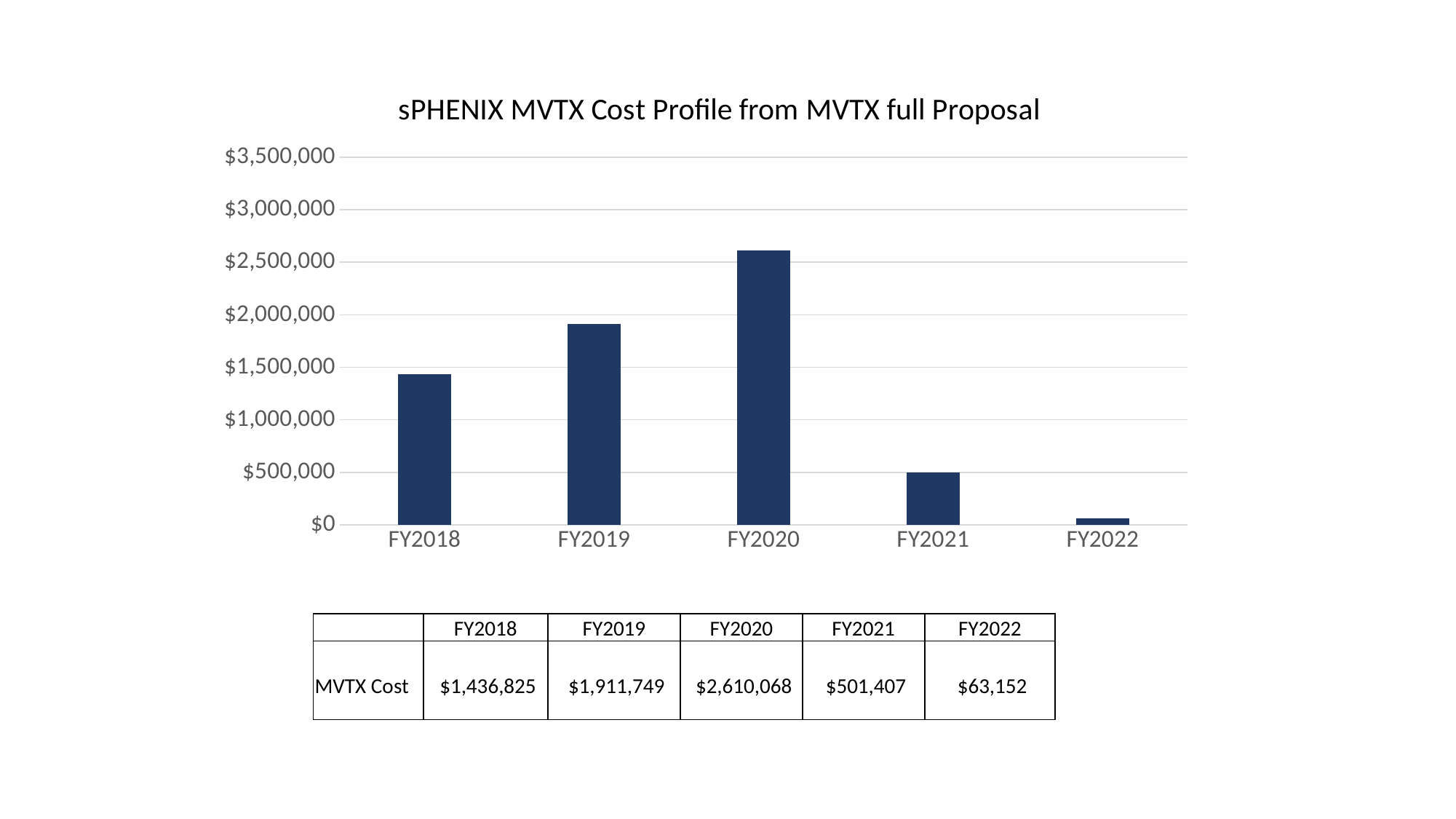
Which fiscal year has the highest MVTX Cost? FY2020 Which fiscal year has the lowest MVTX Cost? FY2022 What is the difference between the MVTX Cost for FY2020 and FY2019? $698,319 What is the difference between the MVTX Cost for FY2021 and FY2022? $438,255 How many fiscal years are shown on the x axis of the chart? 5 What is the MVTX Cost for FY2020? $2,610,068 What is the MVTX Cost for FY2018? $1,436,825 What is the MVTX Cost for FY2022? $63,152 Which is larger, the MVTX Cost for FY2018 or FY2019? FY2019 Is the MVTX Cost for FY2021 greater or less than $1,000,000? less What kind of chart is shown on the slide? bar chart From FY2020 to FY2022, do the MVTX Cost values rise or fall? fall